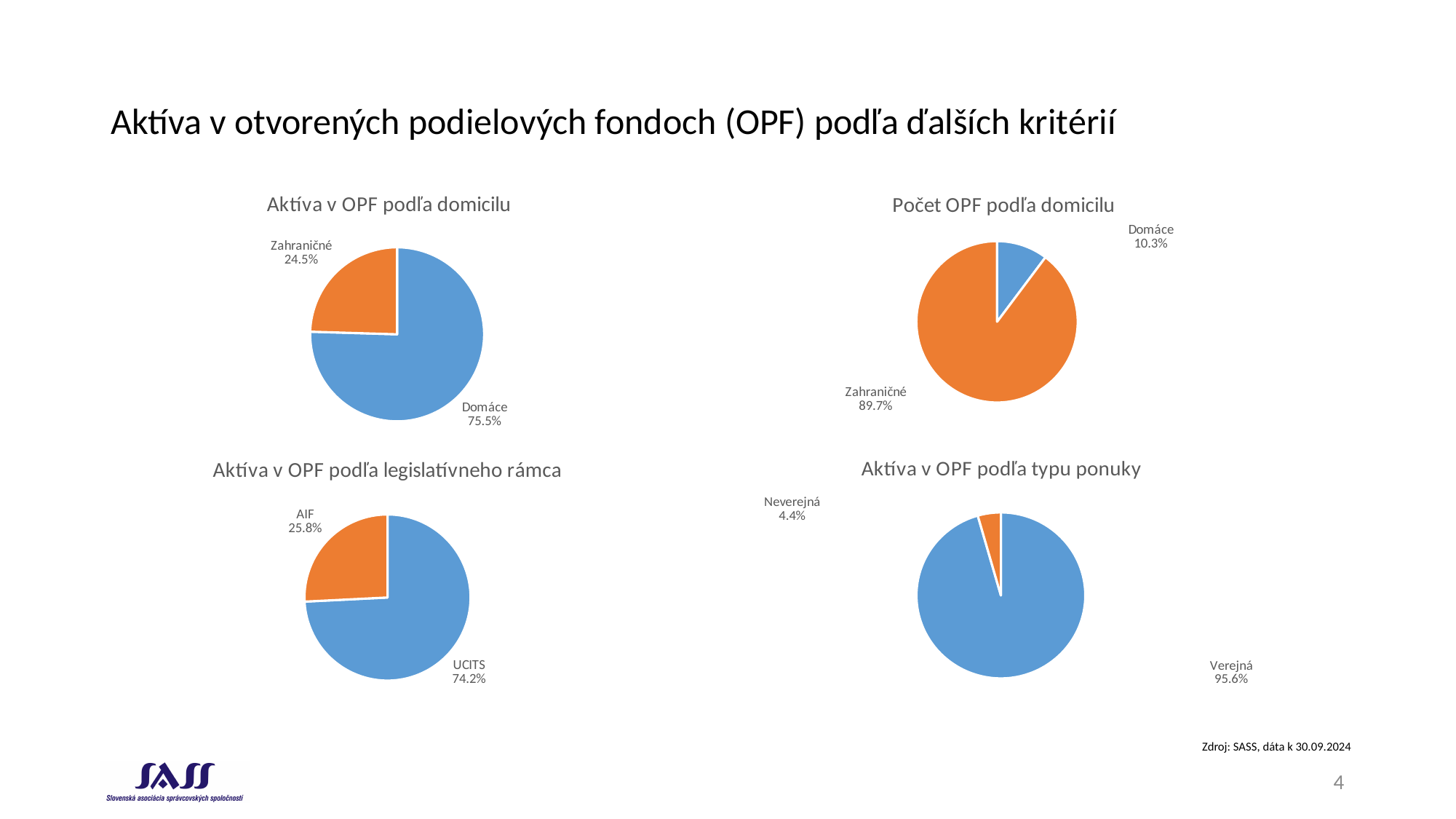
What kind of chart is 'Aktíva v OPF podľa legislatívneho rámca'? Pie chart In the chart titled 'Aktíva v OPF podľa domicilu', what is the value for Zahraničné? 24.5% In the chart titled 'Aktíva v OPF podľa legislatívneho rámca', what is the value for AIF? 25.8% In the chart titled 'Aktíva v OPF podľa domicilu', what share do Domáce funds have? 75.5% In the chart titled 'Počet OPF podľa domicilu', what share do Zahraničné funds have? 89.7% In the chart titled 'Aktíva v OPF podľa typu ponuky', what is the difference between Verejná and Neverejná? 91.2% In the chart titled 'Aktíva v OPF podľa legislatívneho rámca', which category is the largest? UCITS In the chart titled 'Počet OPF podľa domicilu', what is the value for Domáce? 10.3% In the chart titled 'Aktíva v OPF podľa typu ponuky', which category is the smallest? Neverejná In the chart titled 'Počet OPF podľa domicilu', which is larger, Domáce or Zahraničné? Zahraničné How many slices does the chart titled 'Aktíva v OPF podľa domicilu' have? 2 In the chart titled 'Aktíva v OPF podľa typu ponuky', what is the value for Neverejná? 4.4%